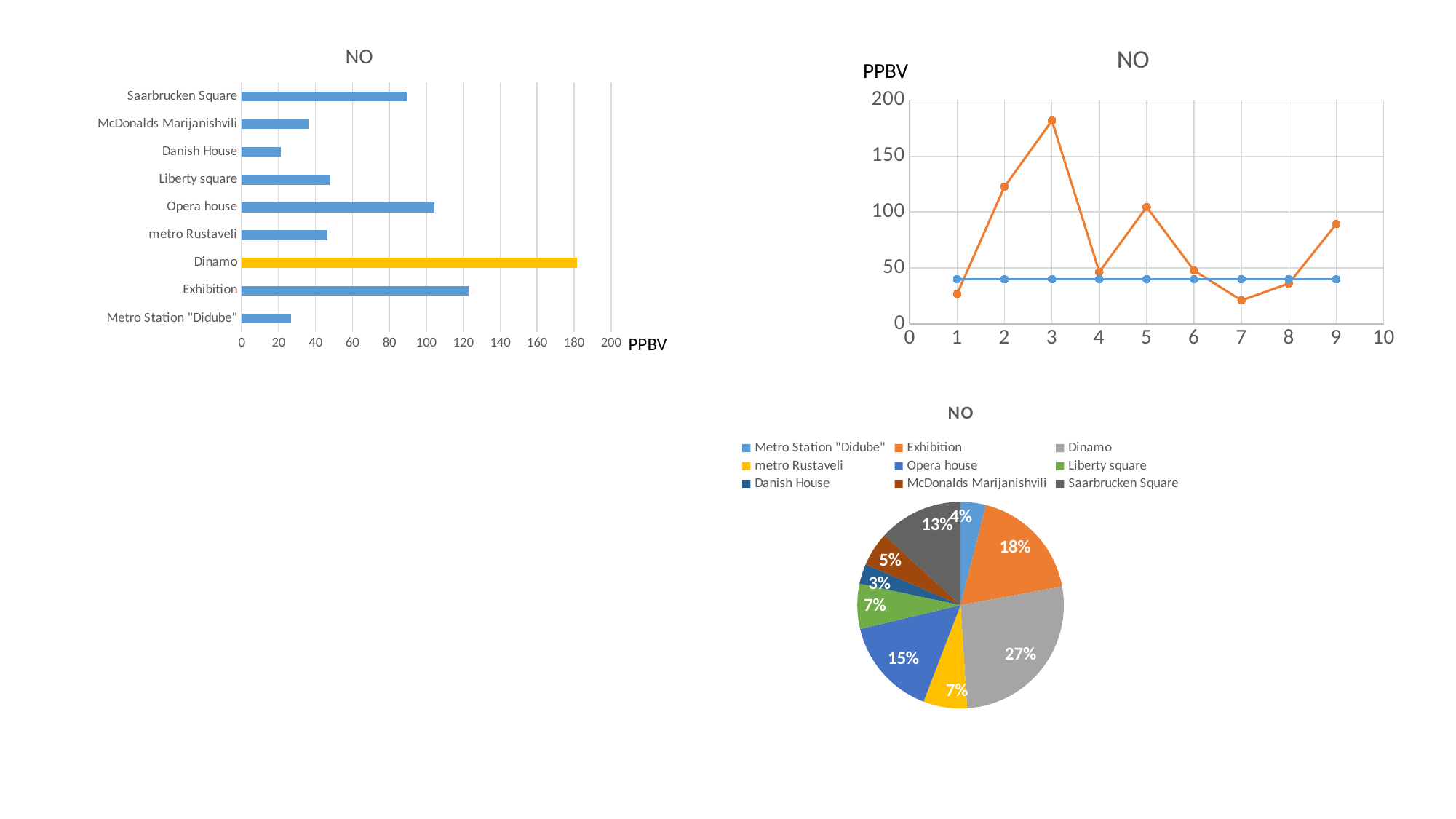
What kind of chart is the chart at the top left of the slide? bar chart How many locations are shown in the bar chart at the top left? 9 In the pie chart at the bottom, what share does Opera house have? 15% In the line chart at the top right, is the orange value at x = 3 greater or less than 150? greater In the pie chart at the bottom, which location has the smallest share? Danish House In the bar chart at the top left, which location has the highest NO value? Dinamo In the line chart at the top right, at which x value does the orange line reach its highest point? 3 In the bar chart at the top left, is the value for Opera house greater or less than 100? greater In the bar chart at the top left, which is larger, the value for Exhibition or the value for Saarbrucken Square? Exhibition In the line chart at the top right, is the orange value at x = 7 greater or less than 50? less In the pie chart at the bottom, what share does Dinamo have? 27%